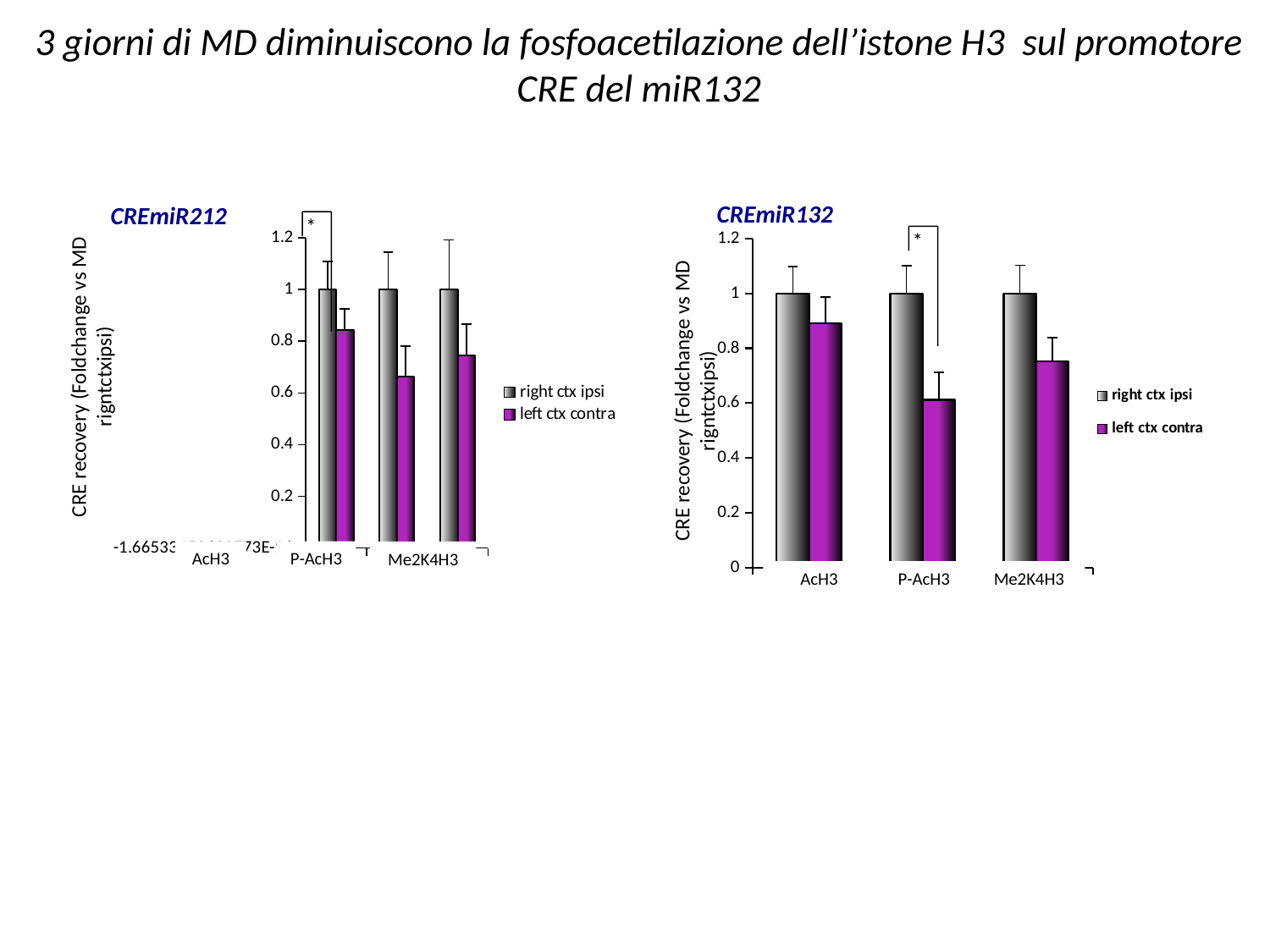
What type of chart is the CREmiR132 chart? bar chart In the CREmiR132 chart, is the value of left ctx contra for P-AcH3 greater or less than 0.8? less In the CREmiR132 chart, is the value of left ctx contra for AcH3 greater or less than 0.8? greater In the CREmiR132 chart, what is the value of right ctx ipsi for P-AcH3? 1 In the CREmiR212 chart, is the value of left ctx contra for Me2K4H3 greater or less than 0.8? less How many series does the legend of the CREmiR132 chart list? 2 In the CREmiR132 chart, how many categories are shown on the x axis? 3 In the CREmiR132 chart, for P-AcH3, which series has the larger value: right ctx ipsi or left ctx contra? right ctx ipsi In the CREmiR132 chart, which category has the lowest left ctx contra value? P-AcH3 In the CREmiR212 chart, what is the value of right ctx ipsi for Me2K4H3? 1 Which series in the CREmiR212 chart is shown in purple? left ctx contra